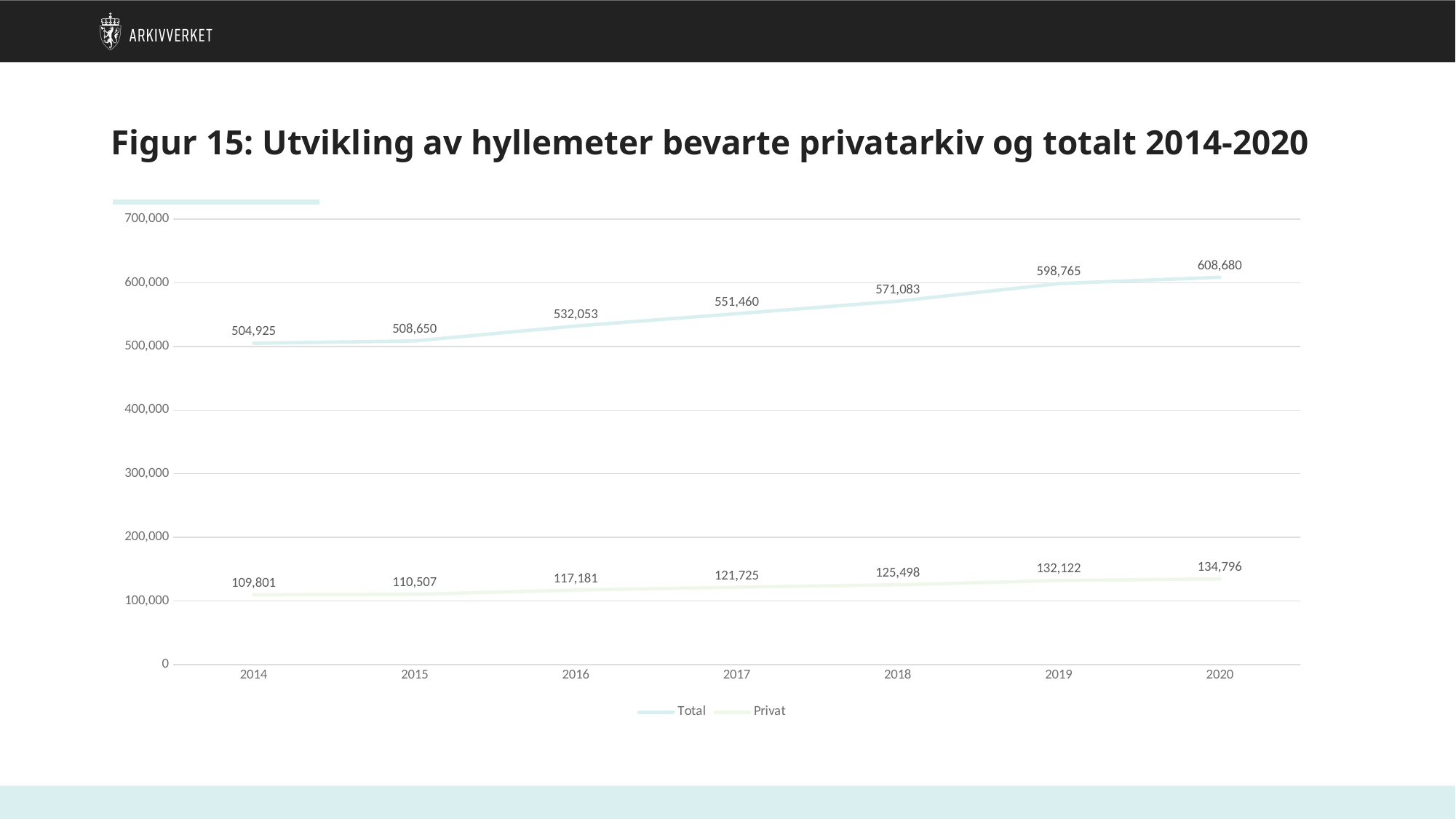
What is the Total value for 2017? 551,460 In which year is the Privat series lowest? 2014 What is the Privat value for 2019? 132,122 How many series does the legend list? 2 What is the Total value for 2014? 504,925 How many years are shown on the x axis? 7 Is the Total value for 2019 greater or less than 600,000? less What is the difference between the Total value in 2020 and the Total value in 2014? 103,755 What is the difference between the Total and Privat values in 2018? 445,585 In which year is the Total series highest? 2020 Which is larger, the Privat value in 2016 or the Privat value in 2015? 2016 What kind of chart is shown on the slide? line chart